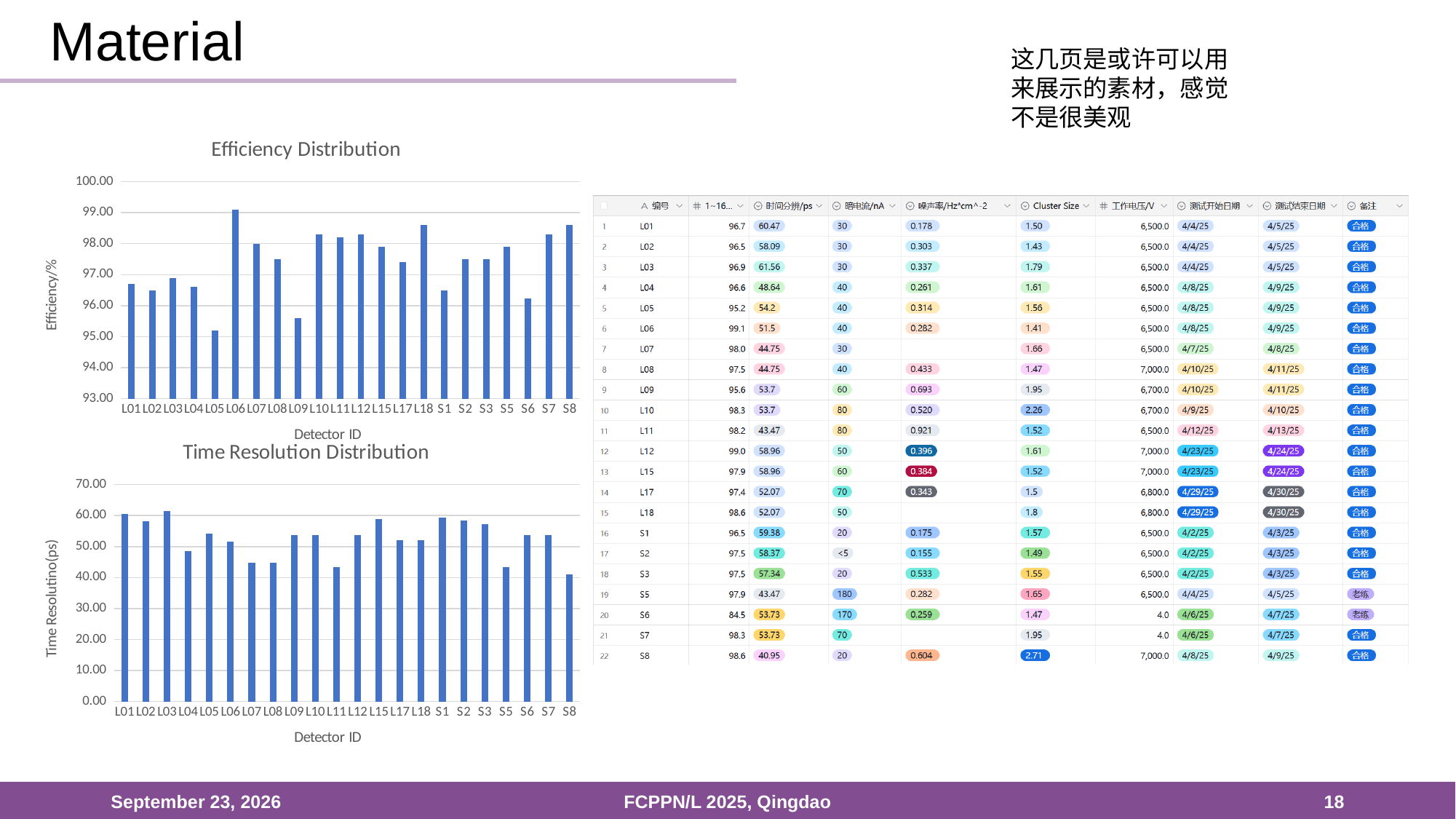
In the Efficiency Distribution chart, is the value for L18 greater or less than 98.00? greater In the Time Resolution Distribution chart, is the value for L15 greater or less than 50.00? greater In the Time Resolution Distribution chart, which detector ID has the lowest time resolution? S8 How many detector IDs are shown on the x axis of the Efficiency Distribution chart? 22 What is the y-axis title of the Efficiency Distribution chart? Efficiency/% In the Efficiency Distribution chart, which has the higher efficiency, L05 or L06? L06 In the Time Resolution Distribution chart, is the value for L07 greater or less than 50.00? less In the Efficiency Distribution chart, which detector ID has the lowest efficiency? L05 In the Time Resolution Distribution chart, which has the larger value, L01 or S8? L01 What kind of chart is the Efficiency Distribution chart? bar chart In the Efficiency Distribution chart, which detector ID has the highest efficiency? L06